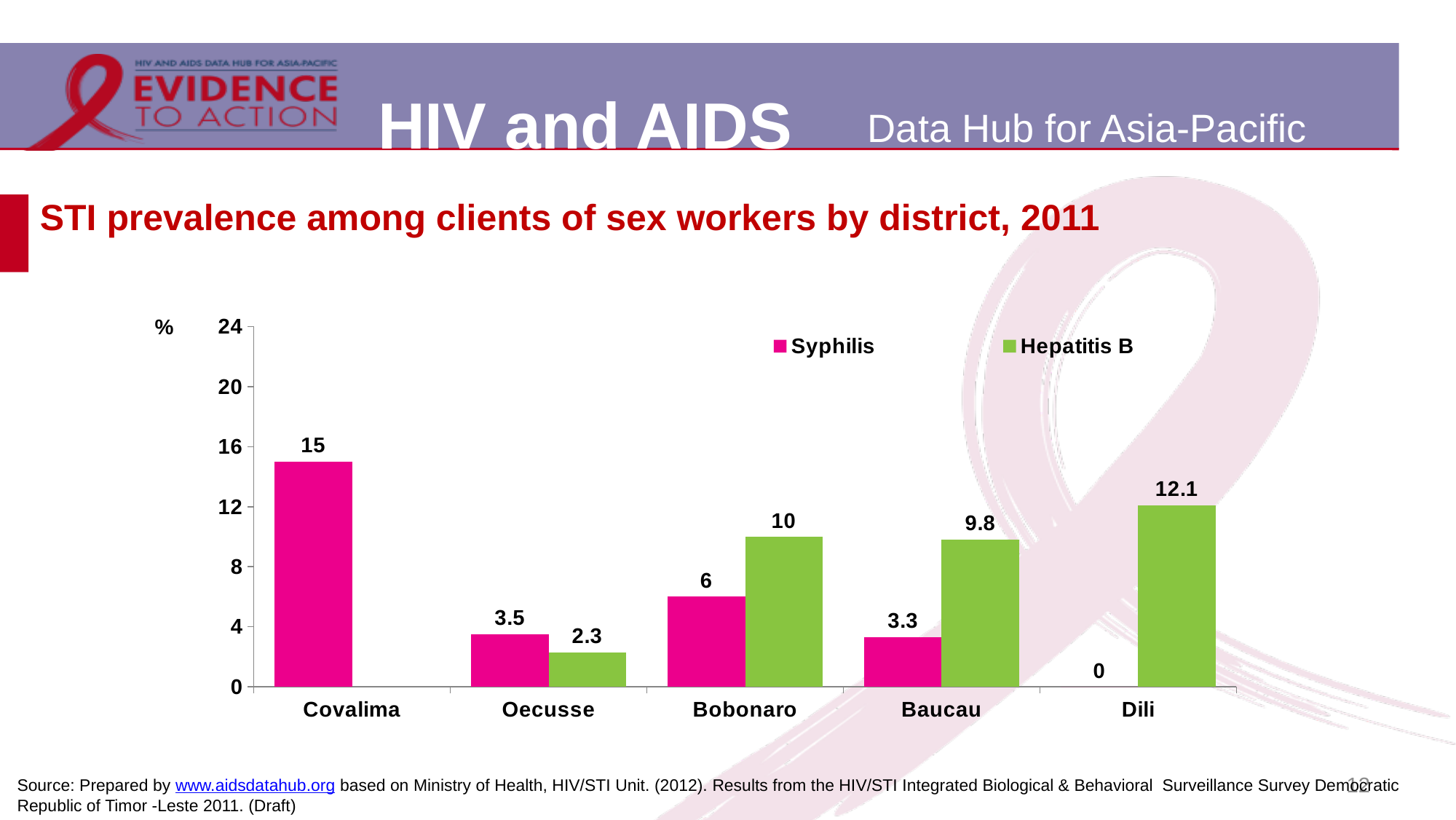
What is the Hepatitis B prevalence for Dili? 12.1 What is the Hepatitis B prevalence for Oecusse? 2.3 Which district has the highest Hepatitis B prevalence? Dili What is the Syphilis prevalence for Baucau? 3.3 What is the Syphilis prevalence for Covalima? 15 Which district has the lowest Syphilis prevalence? Dili What is the difference between the Hepatitis B and Syphilis prevalence in Bobonaro? 4 Which district has the highest Syphilis prevalence? Covalima How many series does the legend list? 2 Which is larger in Oecusse, the Syphilis or the Hepatitis B prevalence? Syphilis What type of chart is shown on the slide? Bar chart How many districts are shown on the x axis? 5